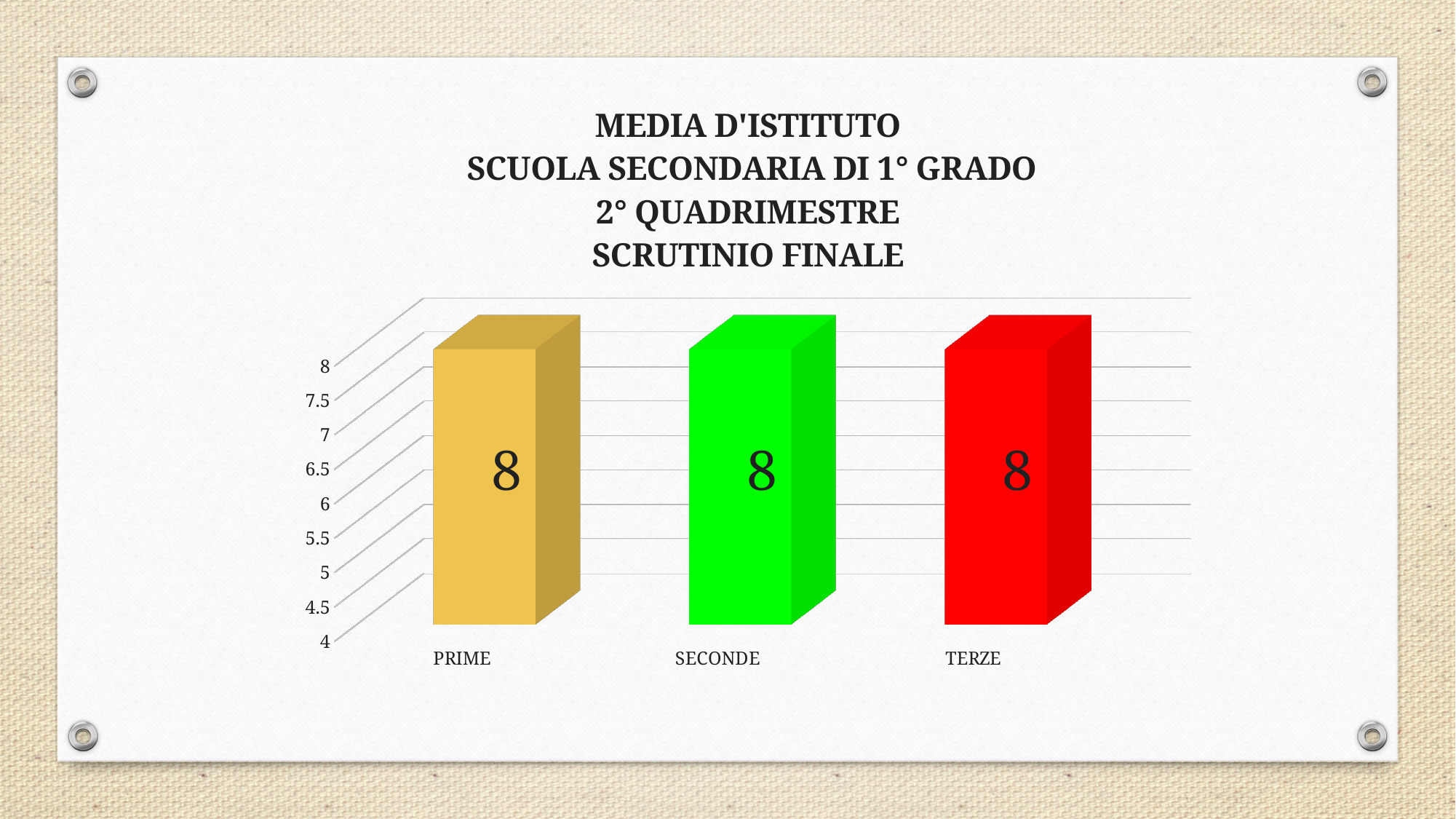
Is the value for TERZE greater or less than 7? greater What is the difference between the values for PRIME and TERZE? 0 How many categories are shown on the x axis? 3 What colour is the bar for SECONDE? green What is the value for TERZE? 8 Do the values rise, fall or stay the same from PRIME to TERZE? stay the same Is the value for SECONDE greater or less than 6? greater What is the value for SECONDE? 8 What kind of chart is shown on the slide? bar chart What is the value for PRIME? 8 What is the lowest value shown on the vertical axis? 4